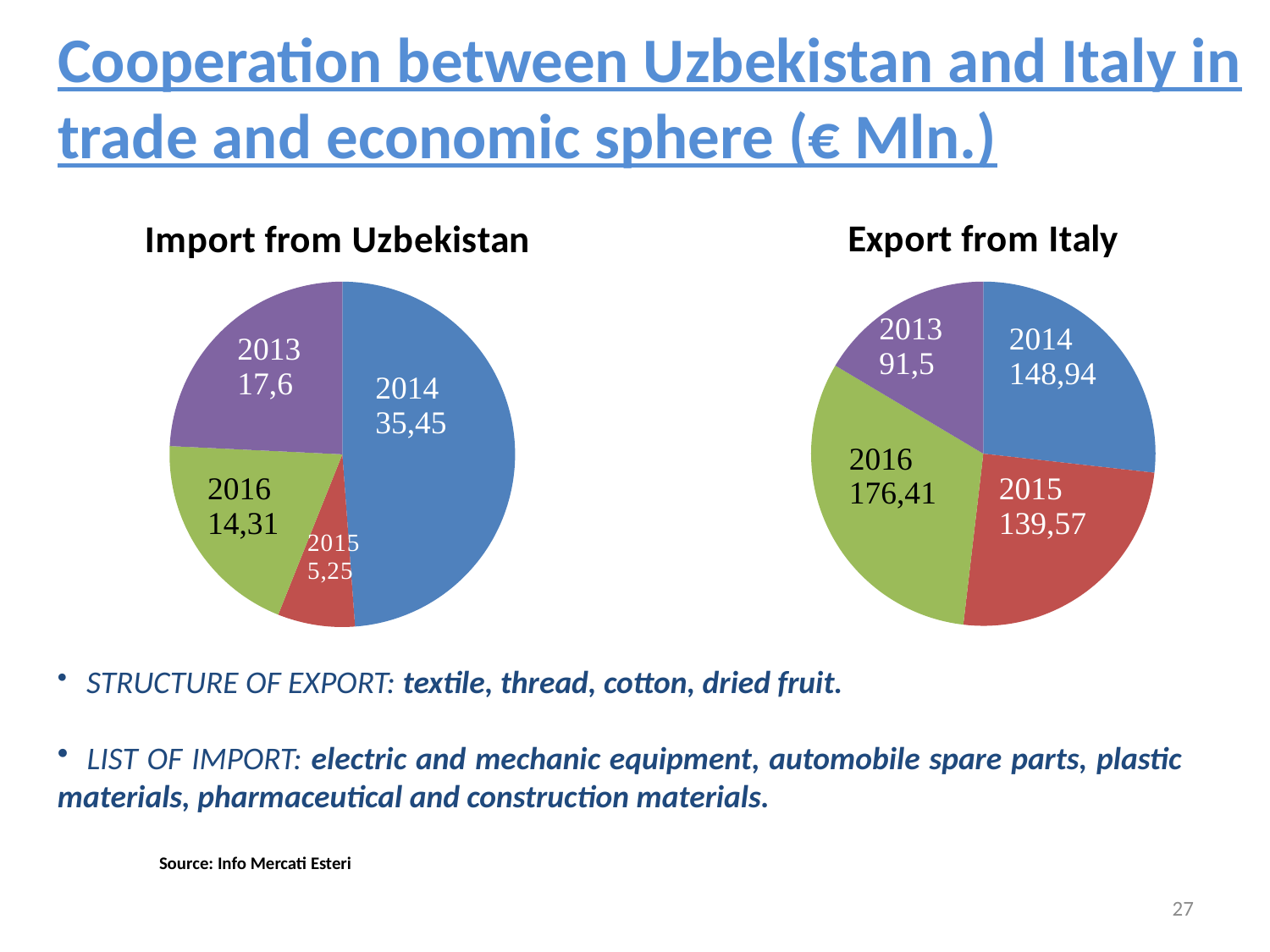
In the 'Import from Uzbekistan' chart, what is the value for 2014? 35,45 In the 'Export from Italy' chart, which year has the smallest slice? 2013 What type of chart is used for 'Import from Uzbekistan'? Pie chart In the 'Import from Uzbekistan' chart, which year has the largest slice? 2014 In the 'Export from Italy' chart, what is the value for 2013? 91,5 In the 'Import from Uzbekistan' chart, what is the difference between the 2014 and 2013 values? 17,85 In the 'Export from Italy' chart, which is larger, the value for 2014 or the value for 2015? 2014 How many slices does the 'Export from Italy' chart have? 4 In the 'Export from Italy' chart, what is the difference between the 2016 and 2015 values? 36,84 In the 'Import from Uzbekistan' chart, which year has the smallest slice? 2015 In the 'Export from Italy' chart, what is the value for 2016? 176,41 In the 'Import from Uzbekistan' chart, what is the value for 2015? 5,25